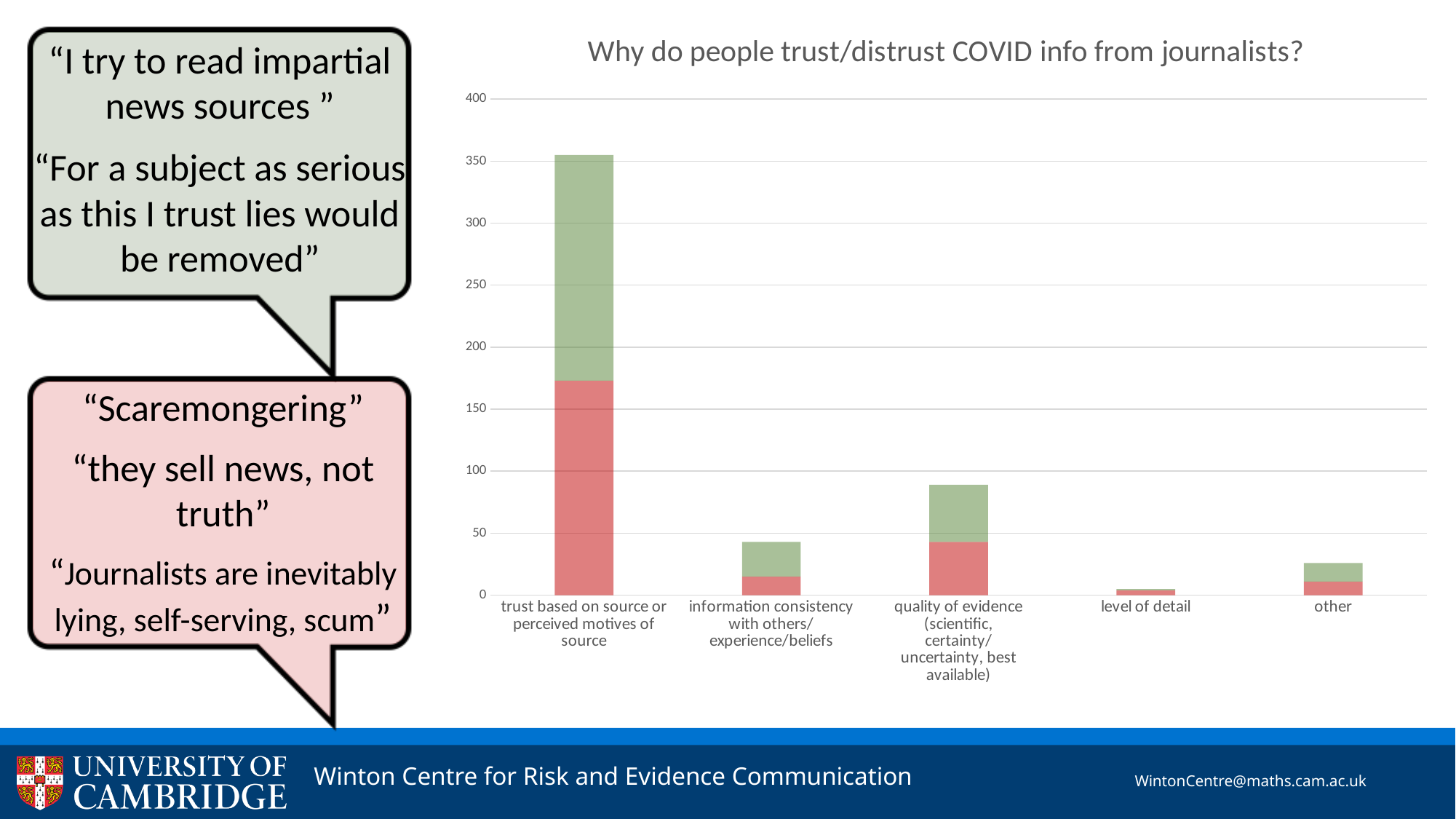
Is the total bar height for 'other' greater or less than 50? less What is the title of the chart? Why do people trust/distrust COVID info from journalists? Which category has the tallest bar? trust based on source or perceived motives of source Is the total bar height for 'information consistency with others/experience/beliefs' greater or less than 50? less Which category has the shortest bar? level of detail Which bar is taller: 'quality of evidence' or 'information consistency with others/experience/beliefs'? quality of evidence What kind of chart is shown on the slide? stacked bar chart Is the total bar height for 'quality of evidence' greater or less than 100? less How many categories are shown on the x axis of the chart? 5 Which bar is taller: 'other' or 'level of detail'? other